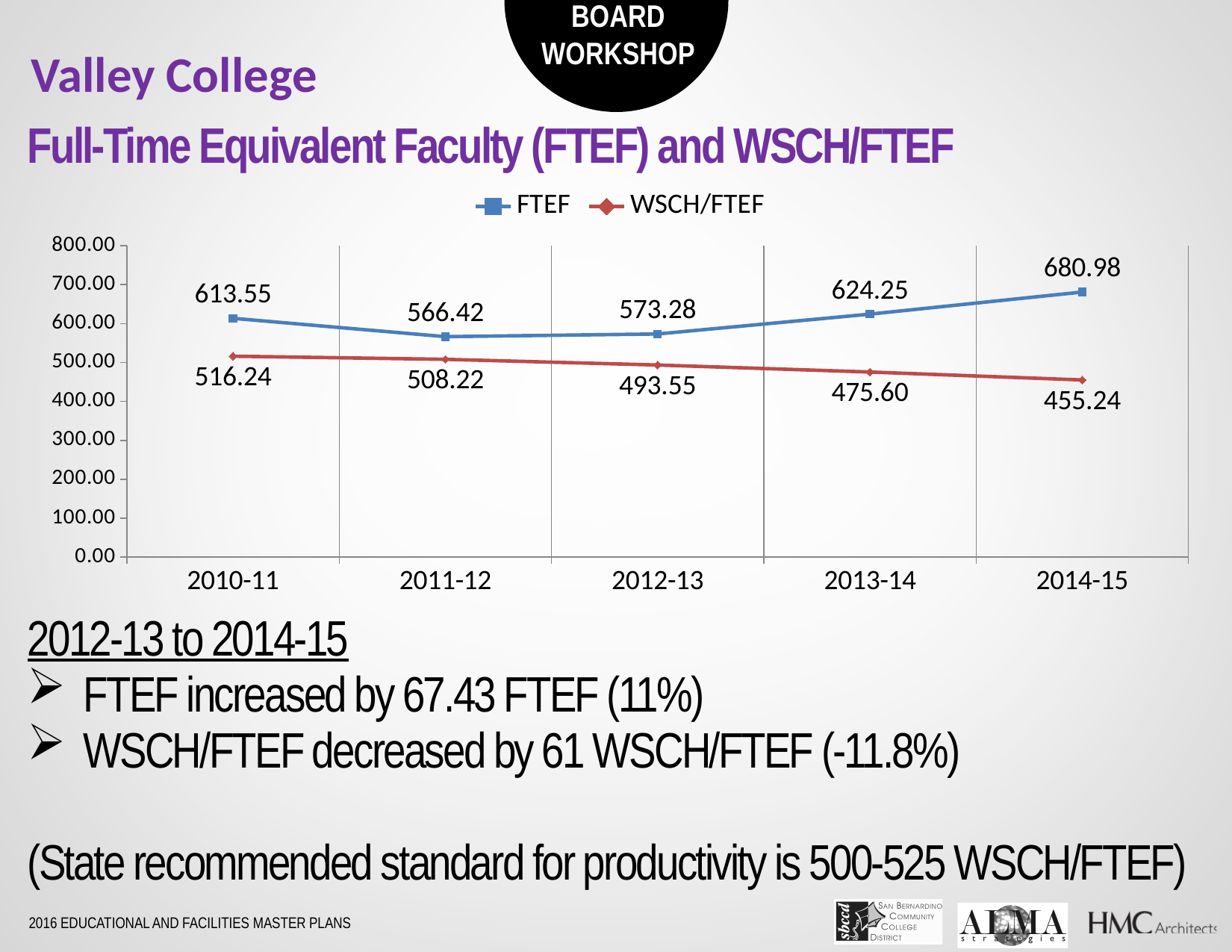
Which year has the highest WSCH/FTEF value? 2010-11 How many years are shown on the x axis? 5 Which year has the lowest FTEF value? 2011-12 What is the difference between the FTEF values for 2014-15 and 2013-14? 56.73 Does the WSCH/FTEF series rise or fall from 2010-11 to 2014-15? fall Which is larger, the WSCH/FTEF value for 2012-13 or for 2013-14? 2012-13 What is the WSCH/FTEF value for 2011-12? 508.22 What kind of chart is shown on the slide? line chart Is the WSCH/FTEF value for 2014-15 greater or less than 500.00? less What is the FTEF value for 2014-15? 680.98 What is the FTEF value for 2012-13? 573.28 How many series does the legend list? 2